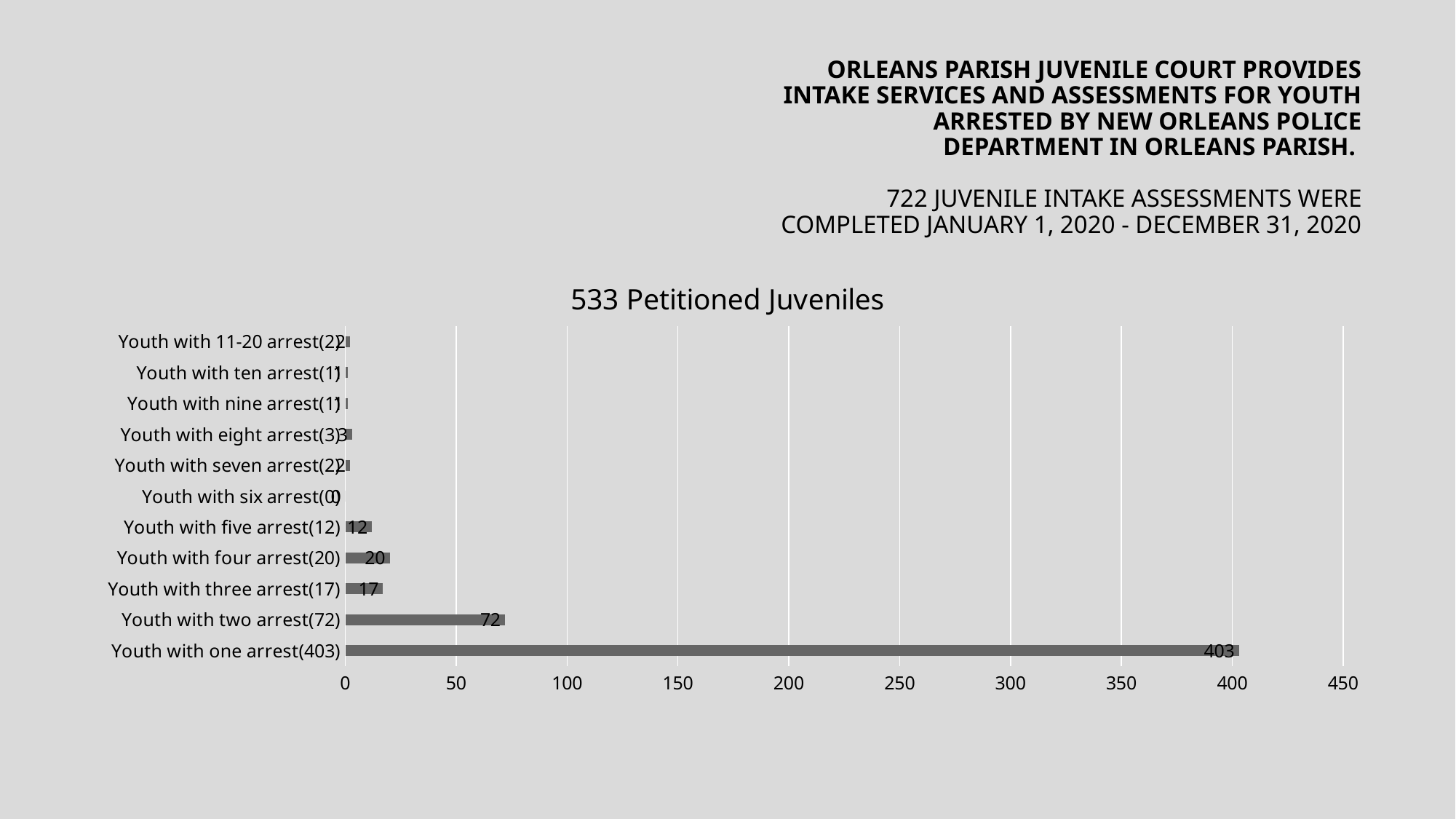
How many categories does the chart show? 11 Which is larger, the value for Youth with three arrest or Youth with four arrest? Youth with four arrest What kind of chart is shown on the slide? bar chart What is the difference between the values for Youth with one arrest and Youth with two arrest? 331 Which category has the highest value? Youth with one arrest Which category has the lowest value? Youth with six arrest What is the value for Youth with four arrest? 20 What is the title of the chart? 533 Petitioned Juveniles What is the value for Youth with two arrest? 72 Is the value for Youth with one arrest greater or less than 350? greater What is the value for Youth with one arrest? 403 What is the value for Youth with six arrest? 0